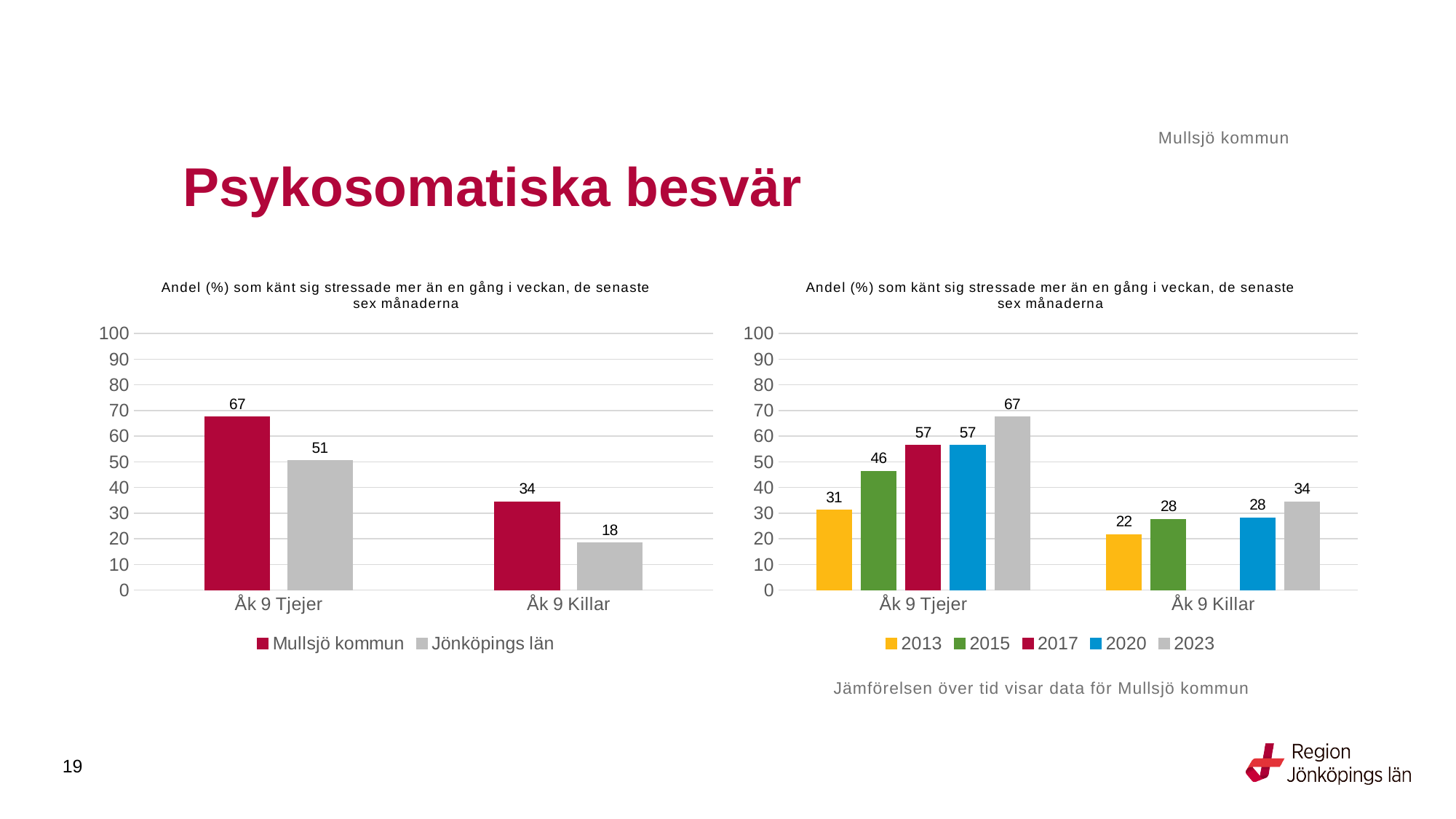
In the right chart, which year has the highest value for Åk 9 Tjejer? 2023 In the right chart, what is the value for 2023 for Åk 9 Killar? 34 How many series does the legend of the right chart list? 5 In the right chart, what is the difference between the 2023 and 2013 values for Åk 9 Tjejer? 36 In the left chart, what is the value for Jönköpings län for Åk 9 Killar? 18 How many series does the legend of the left chart list? 2 In the left chart, what is the difference between Mullsjö kommun and Jönköpings län for Åk 9 Tjejer? 16 In the left chart, what is the value for Mullsjö kommun for Åk 9 Tjejer? 67 What kind of chart is the right chart? Bar chart In the right chart, what is the value for 2013 for Åk 9 Tjejer? 31 In the right chart, which year has the lowest value for Åk 9 Killar? 2013 In the left chart, which is larger for Åk 9 Killar: Mullsjö kommun or Jönköpings län? Mullsjö kommun